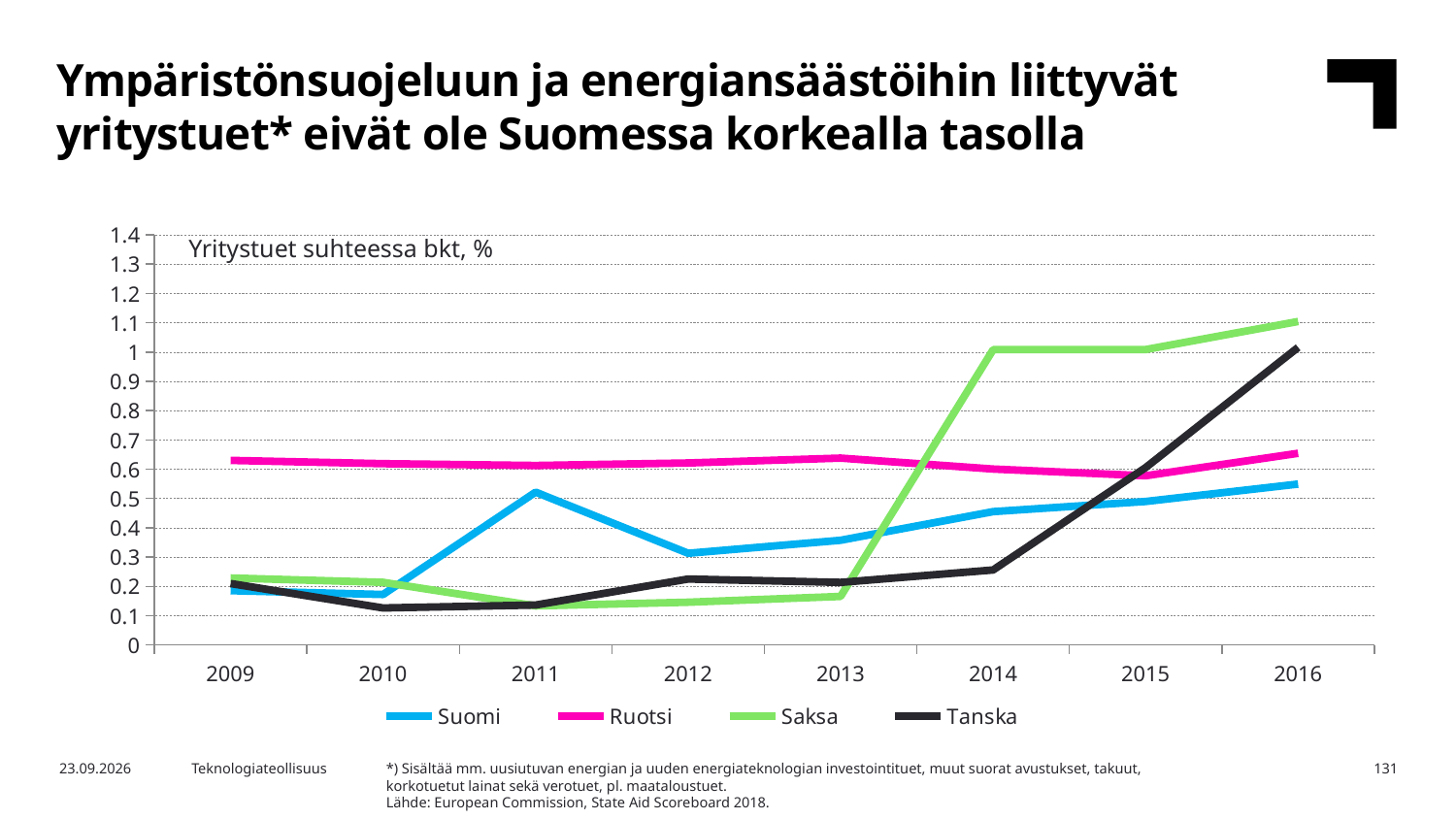
How many years are shown on the x axis? 8 Which country has the highest value in 2009? Ruotsi What is the title shown inside the chart area? Yritystuet suhteessa bkt, % Is the value for Ruotsi in 2009 greater or less than 0.5? greater What kind of chart is shown on the slide? line chart Is the value for Saksa in 2014 greater or less than 0.9? greater Which country has the highest value in 2016? Saksa Is the value for Tanska in 2010 greater or less than 0.2? less Does the value for Tanska rise or fall from 2013 to 2016? rise How many series does the legend list? 4 Which country has the lowest value in 2016? Suomi In 2011, which is larger, the value for Suomi or the value for Tanska? Suomi